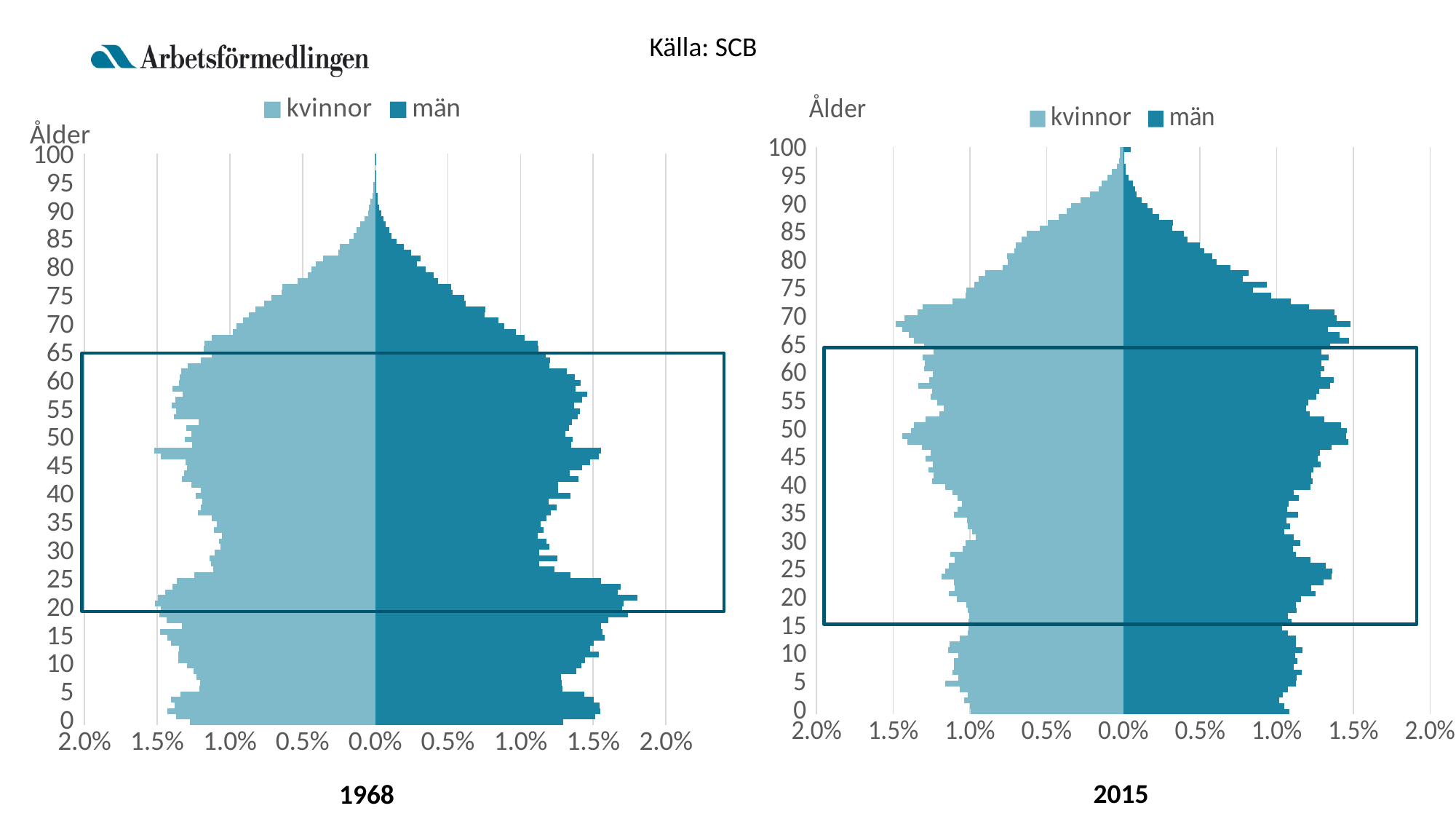
In the 1968 chart, which is larger: the value for män at age 20 or the value for män at age 80? män at age 20 In the 1968 chart, is the value for män at age 20 greater or less than 1.5%? greater In the 1968 chart, is the value for kvinnor at age 90 greater or less than 0.5%? less What are the two series named in the legend of the 1968 chart? kvinnor and män In the 2015 chart, is the value for män at age 25 greater or less than 1.0%? greater In the 1968 chart, do the values for män rise or fall as age increases from 70 to 100? fall What source is cited at the top of the slide? Källa: SCB What kind of chart is the 1968 chart? bar chart In the 2015 chart, which is larger: the value for kvinnor at age 70 or the value for kvinnor at age 90? kvinnor at age 70 How many series does the legend of the 2015 chart list? 2